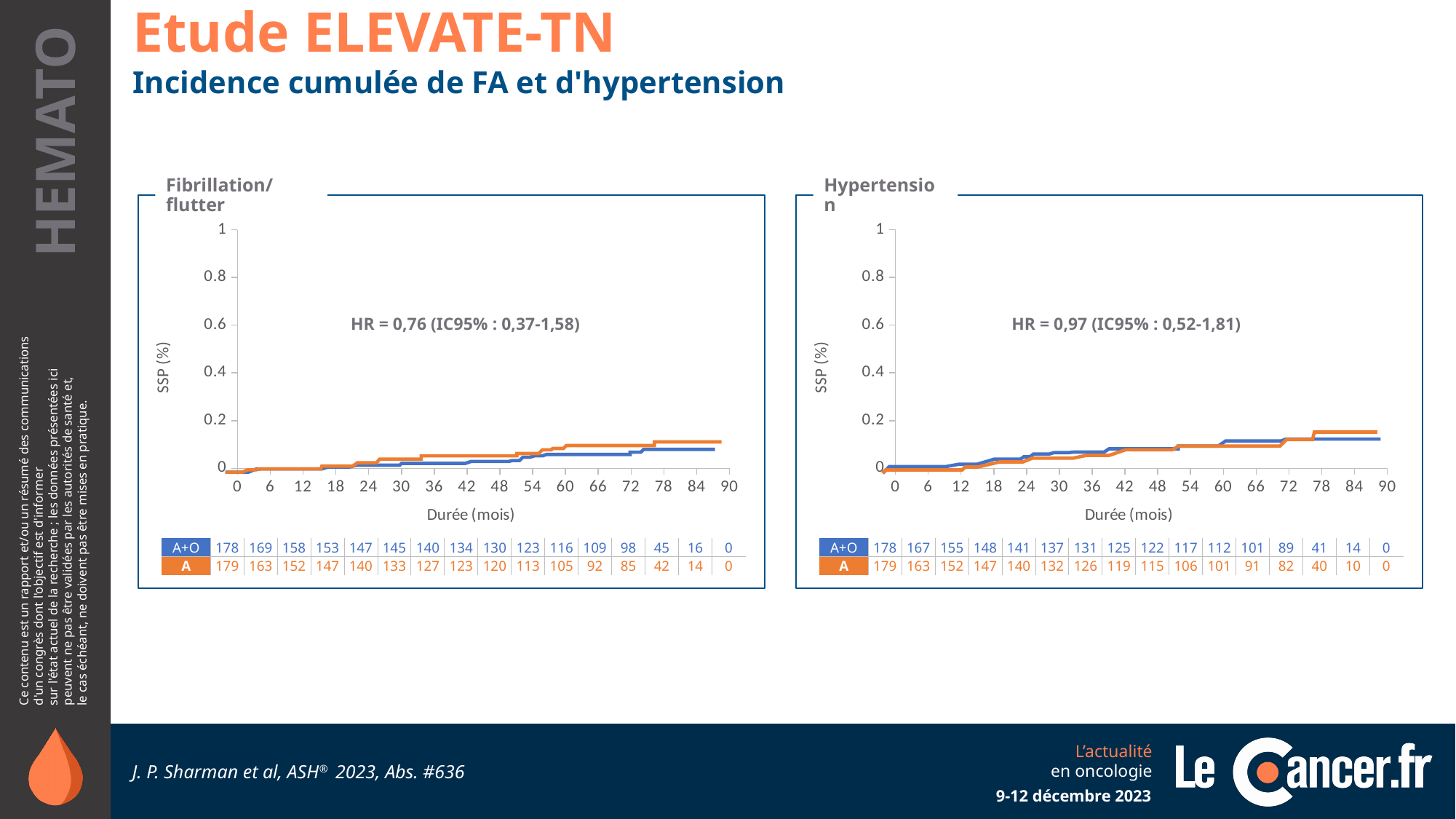
In the Hypertension chart, is the value of the A+O curve at 84 months greater or less than 0.2? less In the Hypertension chart, what hazard ratio is printed on the plot? HR = 0,97 (IC95% : 0,52-1,81) In the Fibrillation/flutter chart, how many patients are at risk in the A+O group at 0 months? 178 In the Fibrillation/flutter chart, is the value of the A curve at 84 months greater or less than 0.2? less In the Hypertension chart, how many patients are at risk in the A+O group at 48 months? 122 What kind of chart is the Fibrillation/flutter chart? line chart In the Fibrillation/flutter chart, what hazard ratio is printed on the plot? HR = 0,76 (IC95% : 0,37-1,58) In the Fibrillation/flutter chart, what is the difference between the number at risk in the A+O group and the A group at 84 months? 2 In the Fibrillation/flutter chart, do the curves rise or fall as duration increases? rise In the Hypertension chart, at 84 months, which curve is higher, A+O or A? A How many series does the legend of the Hypertension chart list? 2 In the Hypertension chart, how many patients are at risk in the A group at 84 months? 10